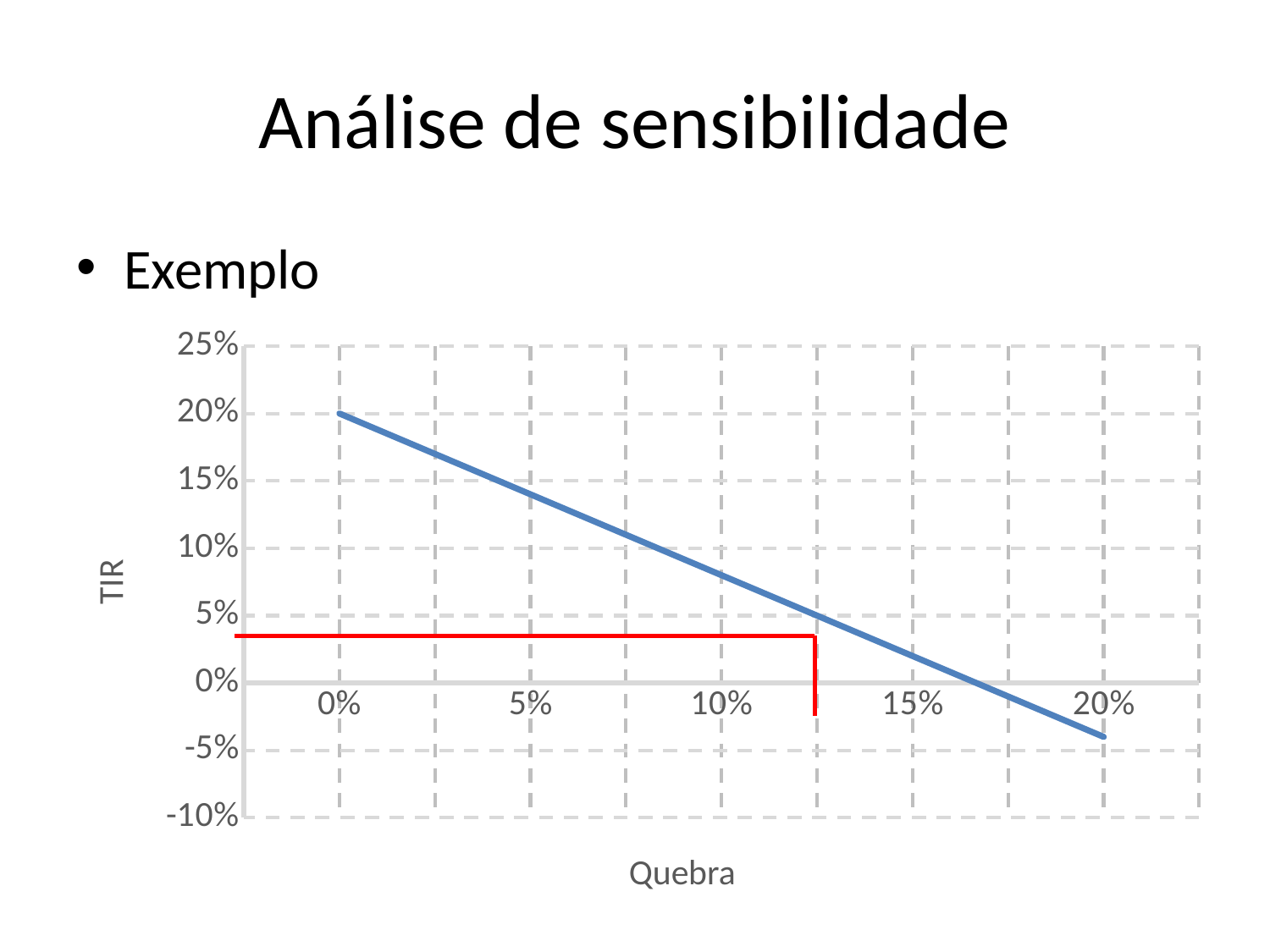
Does the TIR rise or fall as Quebra increases along the x axis? fall Is the TIR value at Quebra 5% greater or less than 10%? greater At which Quebra value is the TIR highest? 0% What is the title of the y axis? TIR Is the TIR value at Quebra 20% greater or less than 0%? less Is the TIR value at Quebra 10% greater or less than 5%? greater What is the TIR value when Quebra is 0%? 20% At which Quebra value is the TIR lowest? 20% What kind of chart is shown on the slide? line chart What is the title of the x axis? Quebra Which has a higher TIR: Quebra 5% or Quebra 15%? Quebra 5%